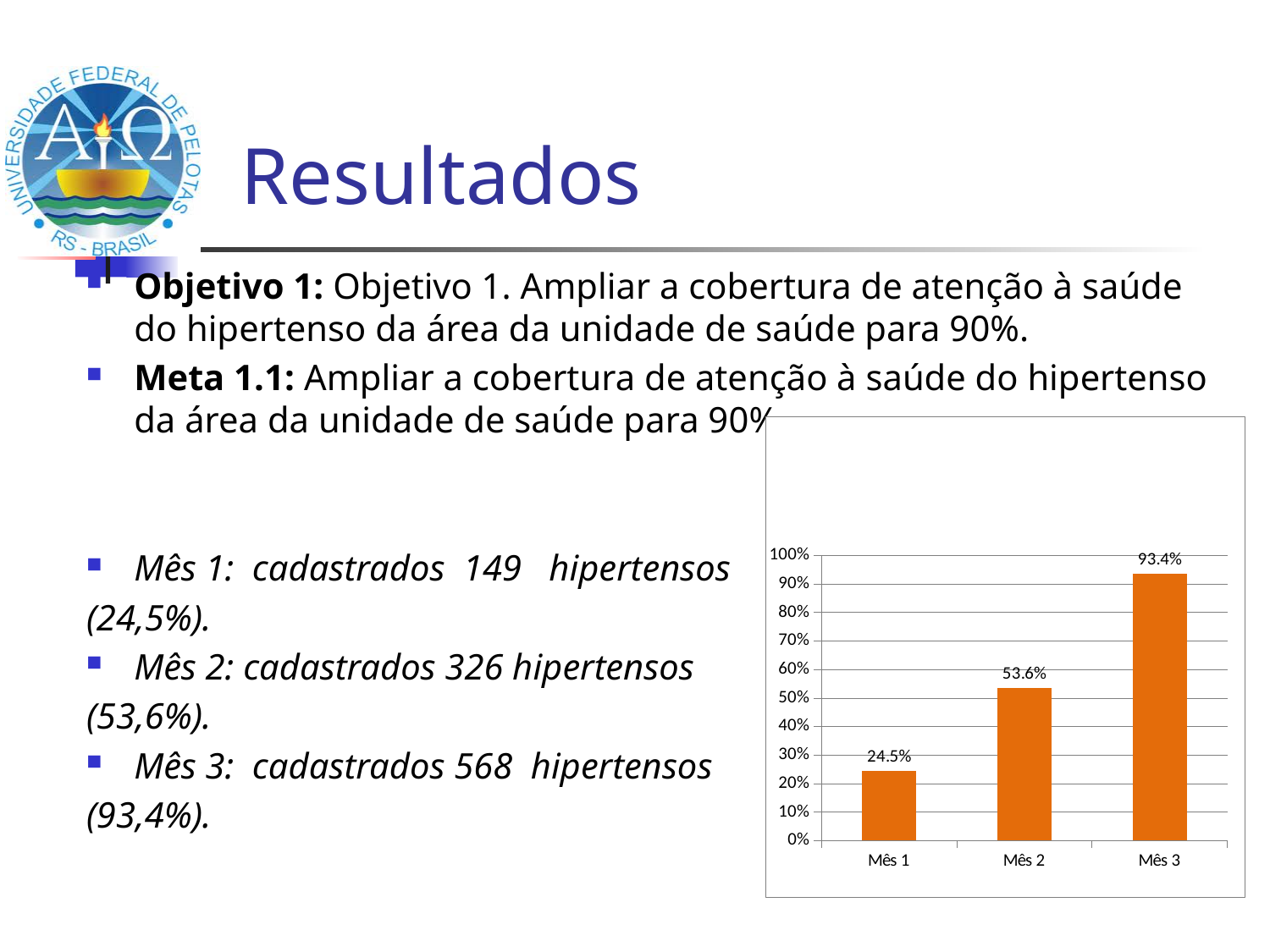
Is the value for Mês 2 greater or less than 50%? greater What is the value for Mês 1 in the chart? 24.5% How many categories are shown on the x axis of the chart? 3 What kind of chart is shown on the slide? bar chart What is the value for Mês 3 in the chart? 93.4% Do the values rise or fall from Mês 1 to Mês 3? rise What is the difference between the values for Mês 3 and Mês 1? 68.9% What is the value for Mês 2 in the chart? 53.6% Which is larger, the value for Mês 2 or the value for Mês 3? Mês 3 Which month has the lowest value in the chart? Mês 1 What is the difference between the values for Mês 2 and Mês 1? 29.1% Which month has the highest value in the chart? Mês 3